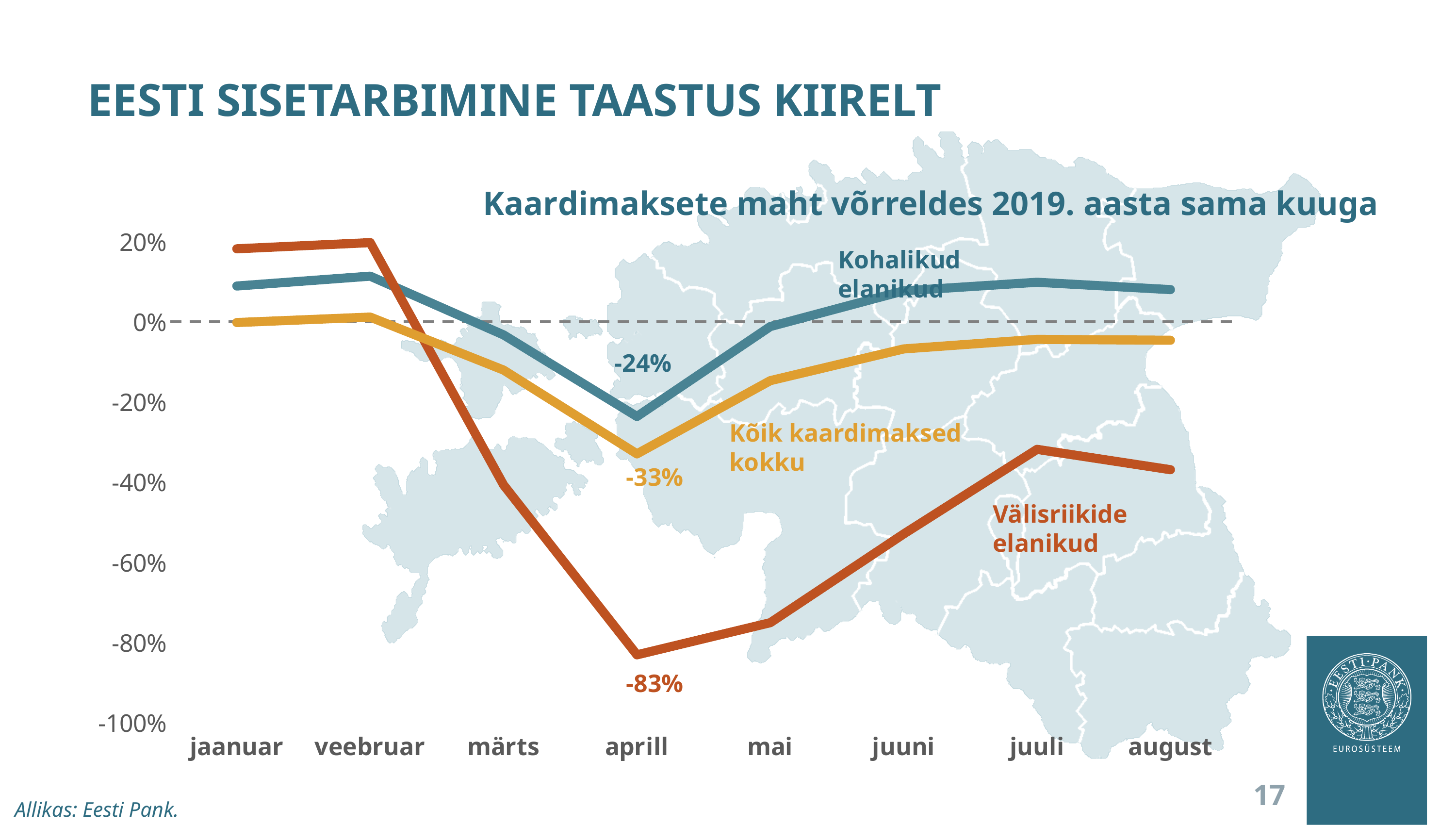
What is the value for Kohalikud elanikud in aprill? -24% Is the value for Välisriikide elanikud in juuli greater or less than -20%? less What is the title of the chart? Kaardimaksete maht võrreldes 2019. aasta sama kuuga Does the Välisriikide elanikud line rise or fall from aprill to juuli? rise In aprill, which series has the lowest value? Välisriikide elanikud How many months are shown on the x axis? 8 What is the value for Kõik kaardimaksed kokku in aprill? -33% What is the difference between the aprill values of Kohalikud elanikud and Välisriikide elanikud? 59 percentage points In aprill, which is larger: the value for Kohalikud elanikud or for Kõik kaardimaksed kokku? Kohalikud elanikud What is the value for Välisriikide elanikud in aprill? -83% What kind of chart is shown on the slide? line chart How many series are plotted on the chart? 3